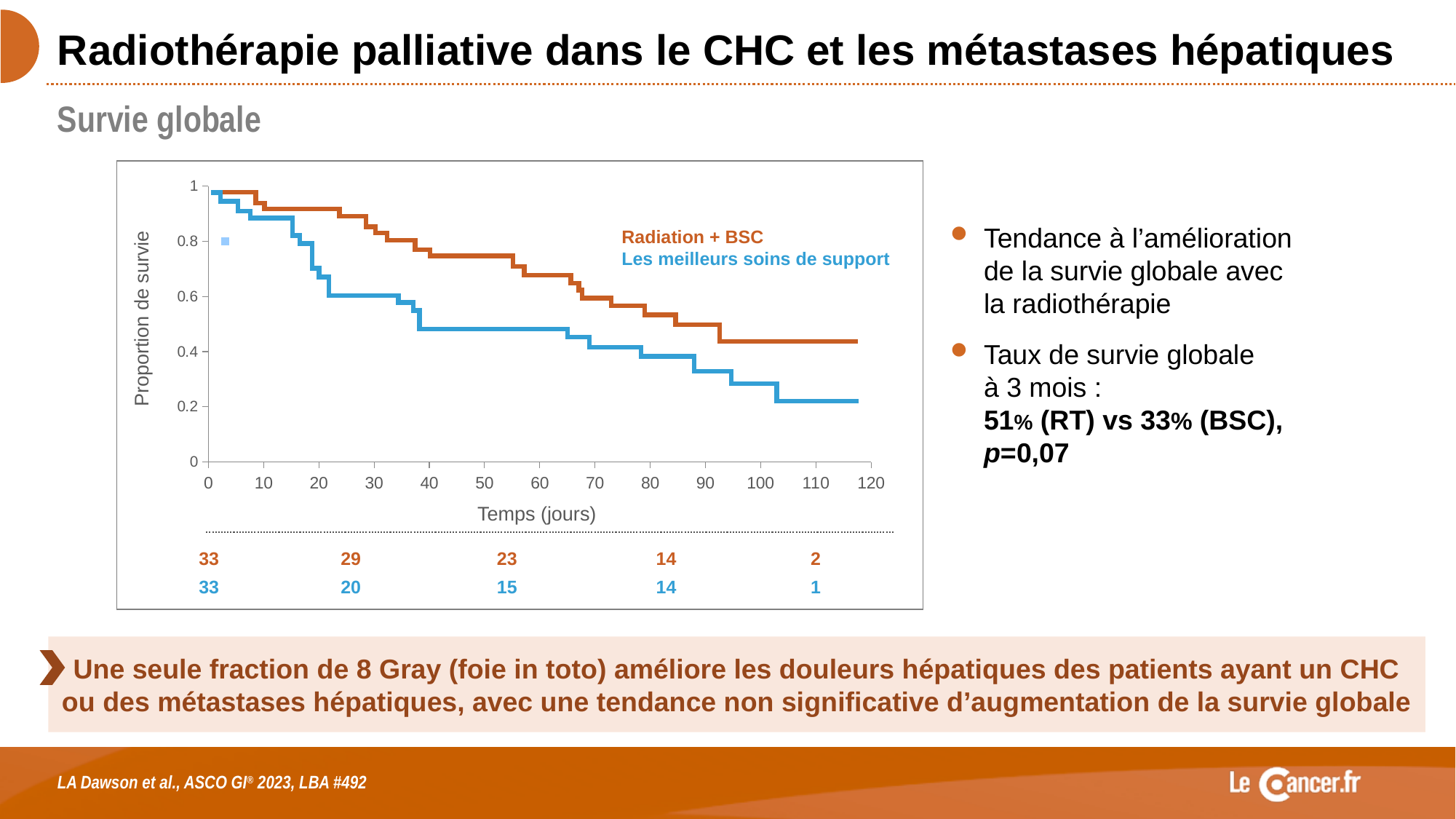
In the numbers-at-risk table below the chart, what is the third value in the Radiation + BSC (orange) row? 23 In the numbers-at-risk table below the chart, what is the second value in the Les meilleurs soins de support (blue) row? 20 Do the survival curves rise or fall as time (jours) increases along the x axis? fall How many series does the chart's legend list? 2 In the numbers-at-risk table, what is the difference between the second value of the orange row (29) and the second value of the blue row (20)? 9 At 100 days, which series has the higher proportion de survie, Radiation + BSC or Les meilleurs soins de support? Radiation + BSC In the numbers-at-risk table, what is the last value in the Les meilleurs soins de support (blue) row? 1 What are the two series named in the chart's legend? Radiation + BSC; Les meilleurs soins de support What kind of chart is shown on the slide? line chart At 60 days, is the value for Les meilleurs soins de support greater or less than 0.6? less At 60 days, is the value for Radiation + BSC greater or less than 0.6? greater What is the label of the chart's y axis? Proportion de survie